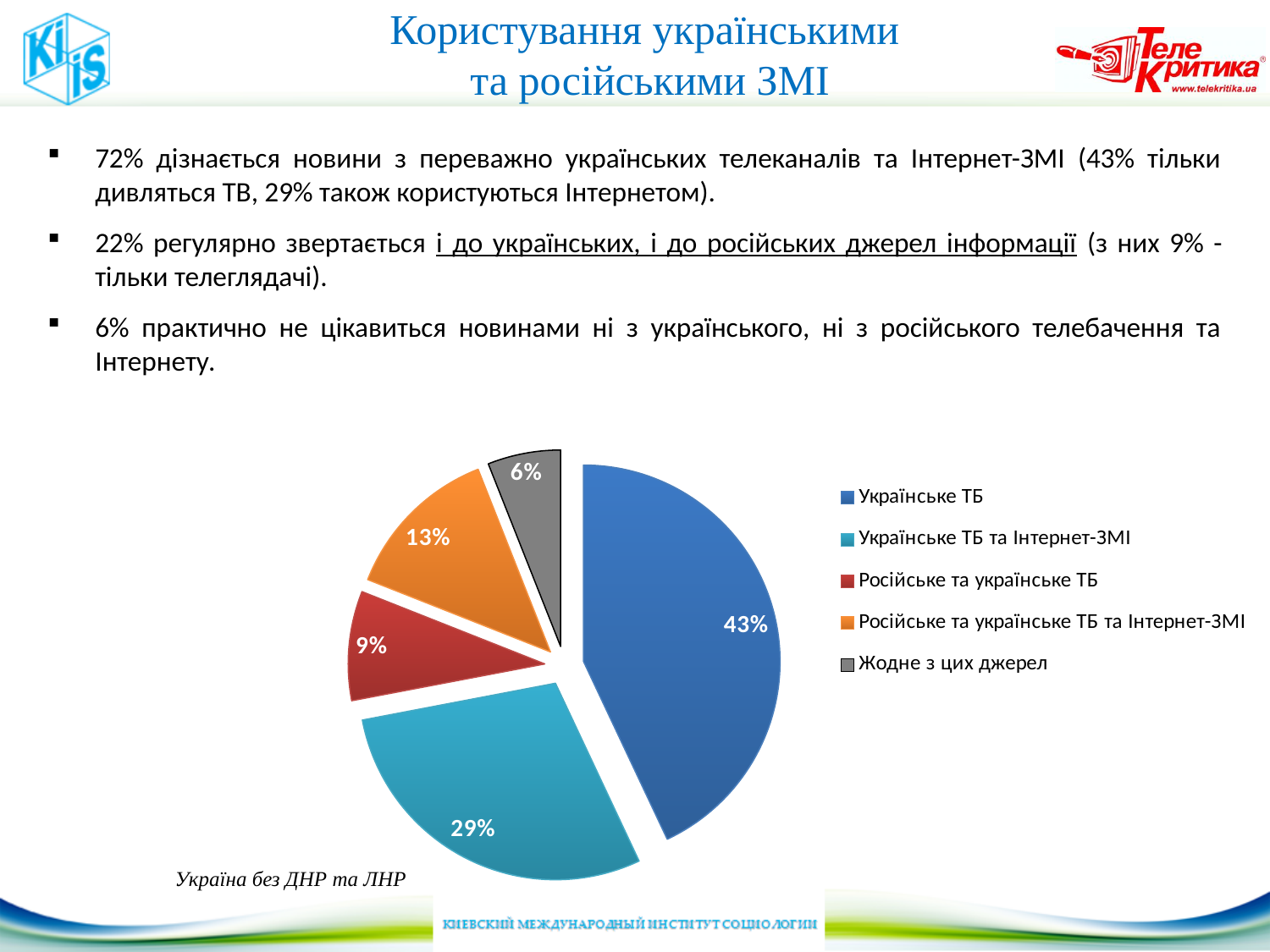
Which category has the largest slice of the pie? Українське ТБ What share of the pie does "Українське ТБ та Інтернет-ЗМІ" account for? 29% What share of the pie does "Українське ТБ" account for? 43% What share of the pie does "Жодне з цих джерел" account for? 6% What type of chart is shown on the slide? Pie chart How many slices does the pie chart have? 5 Which category has the smallest slice of the pie? Жодне з цих джерел Which is larger: the slice for "Російське та українське ТБ та Інтернет-ЗМІ" or the slice for "Російське та українське ТБ"? Російське та українське ТБ та Інтернет-ЗМІ What share of the pie does "Російське та українське ТБ" account for? 9% What colour is the slice for "Жодне з цих джерел"? Grey What share of the pie does "Російське та українське ТБ та Інтернет-ЗМІ" account for? 13% What is the difference in percentage points between "Українське ТБ" and "Українське ТБ та Інтернет-ЗМІ"? 14